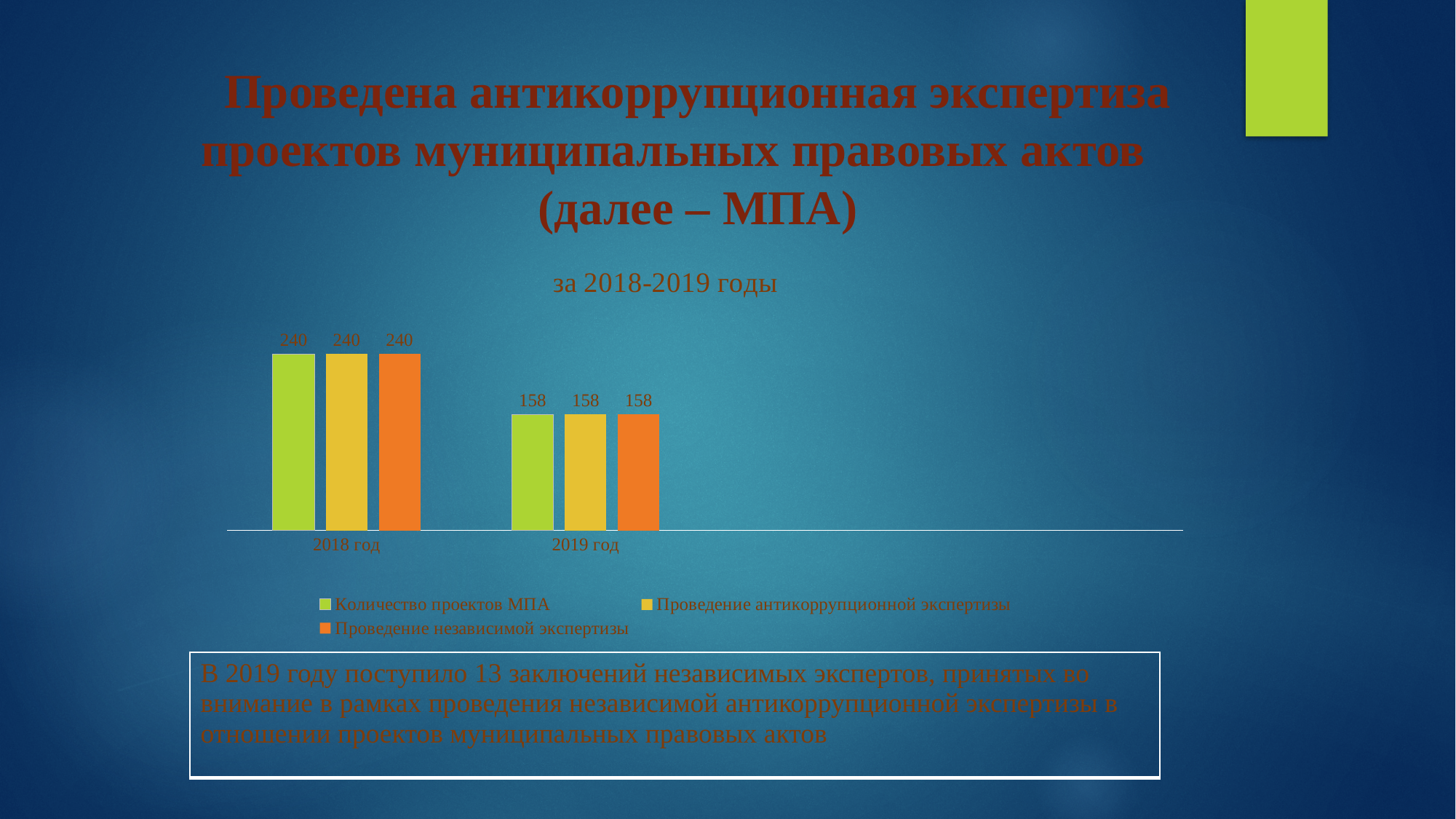
What is the value of "Количество проектов МПА" for 2018 год? 240 What is the difference between the "Количество проектов МПА" values for 2018 год and 2019 год? 82 Do the values rise or fall from 2018 год to 2019 год? Fall What is the value of "Проведение независимой экспертизы" for 2018 год? 240 Which series is shown in orange in the chart legend? Проведение независимой экспертизы Is the value of "Проведение антикоррупционной экспертизы" larger in 2018 год or 2019 год? 2018 год How many series does the chart legend list? 3 How many categories are shown on the x axis of the chart? 2 Which year has the higher value for "Количество проектов МПА"? 2018 год What is the value of "Проведение антикоррупционной экспертизы" for 2019 год? 158 What kind of chart is shown on the slide? Bar chart Which year has the lowest value for "Проведение независимой экспертизы"? 2019 год